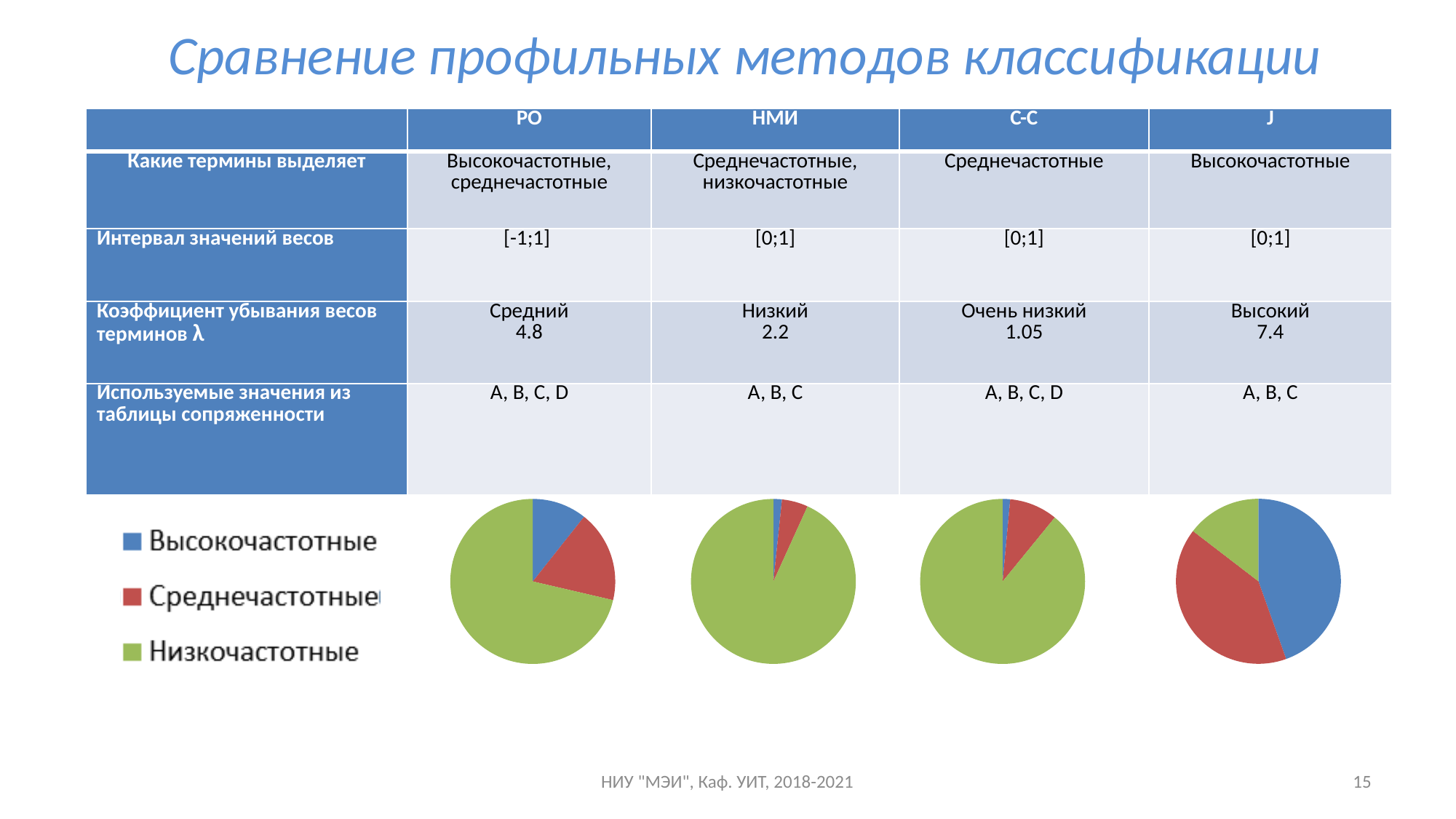
Which colour represents Среднечастотные in the pie chart legend? Red In the rightmost pie chart (under the J column), which category has the largest slice? Высокочастотные In the third pie chart from the left (under the С-С column), which is larger: the Среднечастотные slice or the Высокочастотные slice? Среднечастотные In the leftmost pie chart (under the РО column), which category has the largest slice? Низкочастотные In the second pie chart from the left (under the НМИ column), which category has the largest slice? Низкочастотные In the second pie chart from the left (under the НМИ column), which category has the smallest slice? Высокочастотные How many pie charts are shown on the slide? 4 In the leftmost pie chart (under the РО column), which category has the smallest slice? Высокочастотные Which colour represents Низкочастотные in the pie chart legend? Green How many entries does the legend for the pie charts list? 3 What kind of chart is shown in the bottom row of the slide? Pie chart In the rightmost pie chart (under the J column), which category has the smallest slice? Низкочастотные